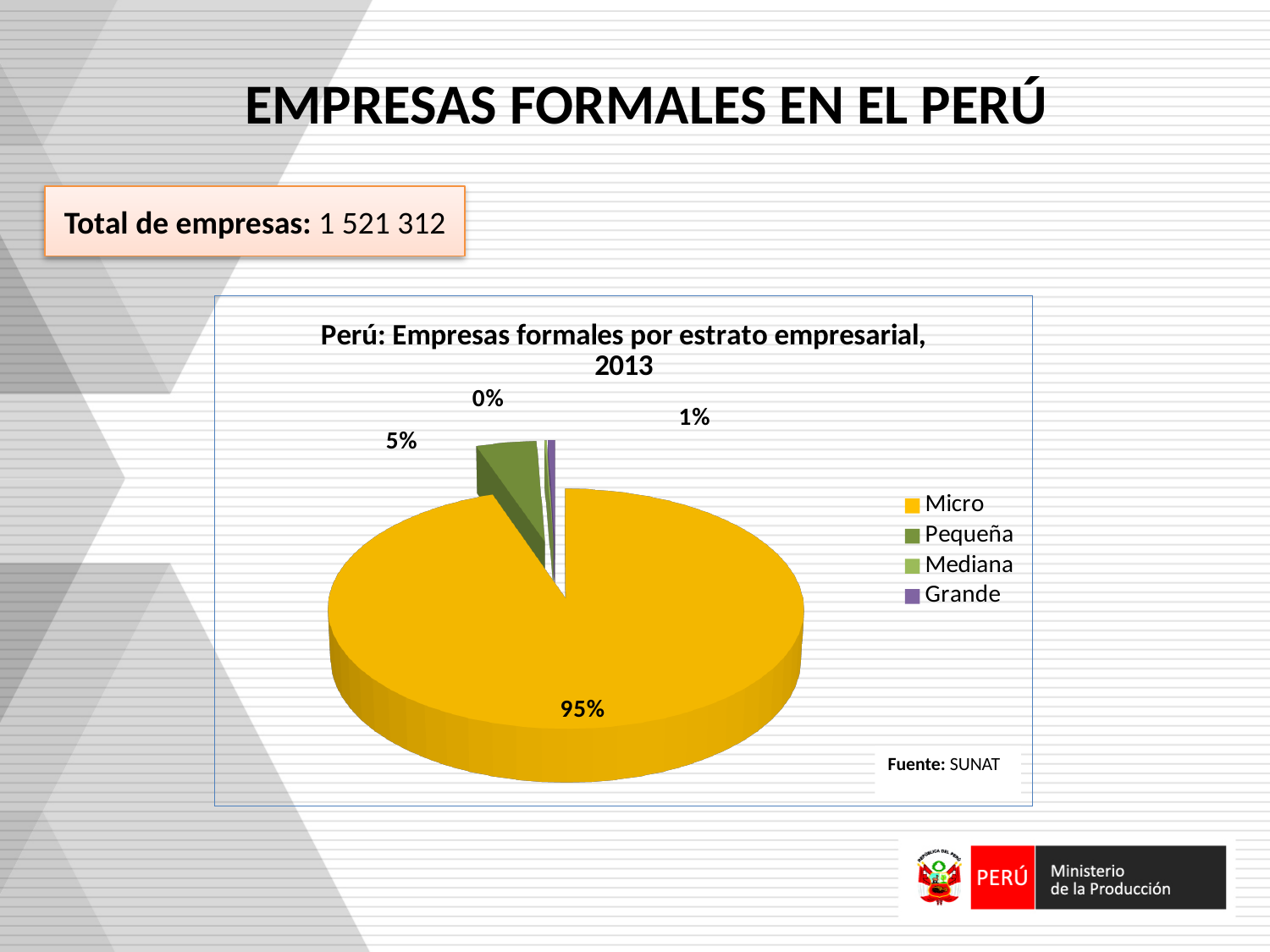
What source is cited for the pie chart? SUNAT Which business stratum has the smallest share of the pie? Mediana Which has a larger share, Micro or Pequeña? Micro What share of formal companies does the Micro slice represent? 95% What is the title of the pie chart? Perú: Empresas formales por estrato empresarial, 2013 What share of formal companies does the Pequeña slice represent? 5% Which business stratum has the largest share of the pie? Micro What is the difference in percentage points between the Micro share and the Pequeña share? 90 percentage points What share of formal companies does the Mediana slice represent? 0% What share of formal companies does the Grande slice represent? 1% How many categories does the legend of the pie chart list? 4 What kind of chart is shown on the slide? pie chart